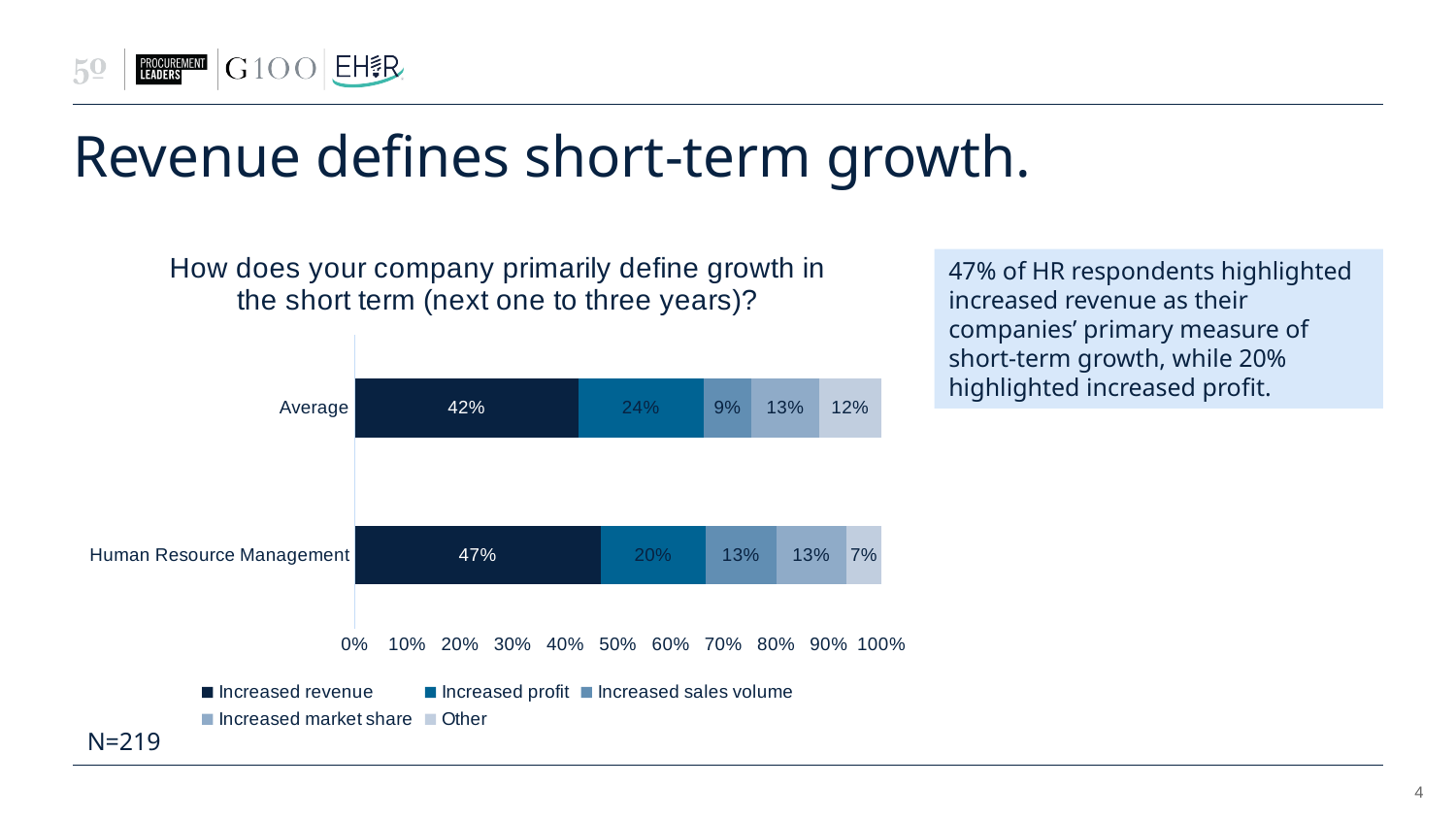
What is the value for Other in the Human Resource Management bar? 7% What type of chart is shown on the slide? Stacked bar chart What is the total of the Human Resource Management stacked bar? 100% What is the value for Increased revenue in the Human Resource Management bar? 47% Which is larger: Increased sales volume for Human Resource Management or for Average? Human Resource Management What is the value for Increased sales volume in the Average bar? 9% What is the difference between the Increased revenue values for Human Resource Management and Average? 5% Which series has the largest segment in the Average bar? Increased revenue Which series has the smallest segment in the Human Resource Management bar? Other What is the value for Increased profit in the Average bar? 24% How many categories (bars) are shown in the chart? 2 How many series does the legend list? 5